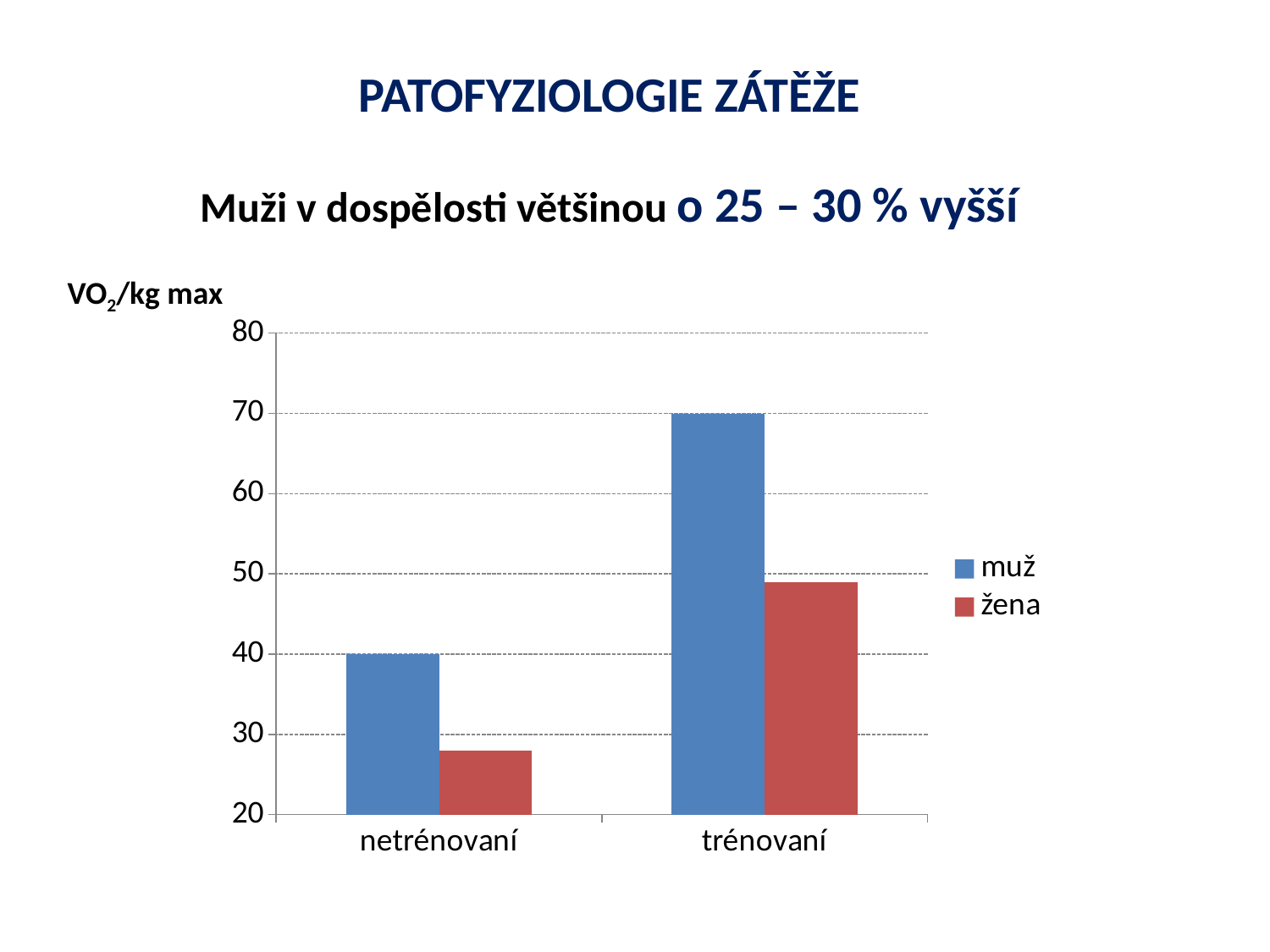
How many categories are shown on the x axis? 2 How many series does the legend list? 2 In the trénovaní category, which is larger: the value for muž or the value for žena? muž Which series is shown in blue in the legend? muž Which category has the highest muž value? trénovaní What is the value for muž in the trénovaní category? 70 Is the value for žena in the netrénovaní category greater or less than 30? less What is the value for muž in the netrénovaní category? 40 Which category has the lowest žena value? netrénovaní What kind of chart is shown on the slide? bar chart What is the difference between the muž value for trénovaní and the muž value for netrénovaní? 30